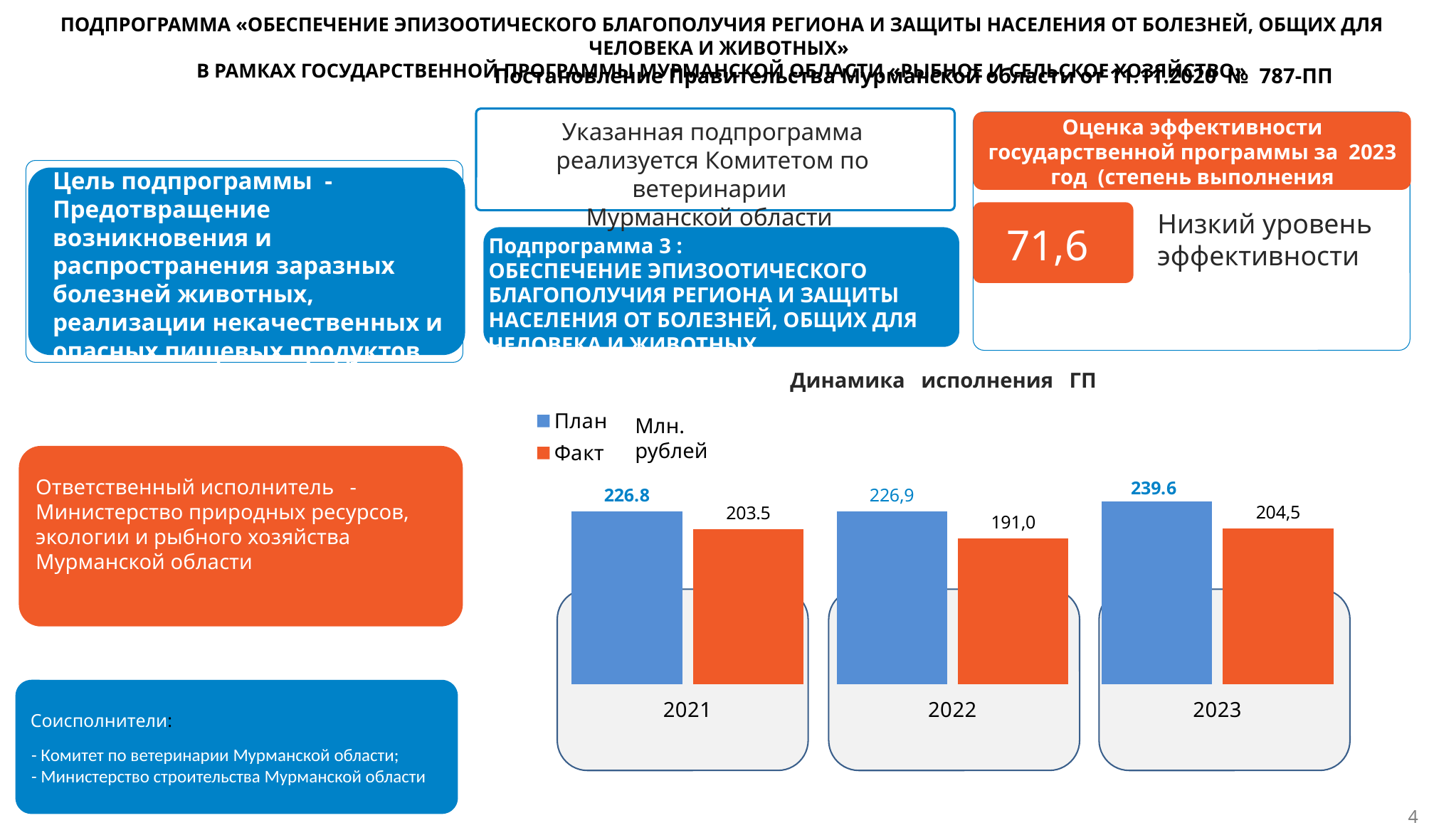
What is the Факт value for 2023 in the chart 'Динамика исполнения ГП'? 204,5 In the chart 'Динамика исполнения ГП', what unit is indicated next to the legend? Млн. рублей In the chart 'Динамика исполнения ГП', what is the difference between План and Факт for 2023? 35.1 In the chart 'Динамика исполнения ГП', what is the difference between План and Факт for 2021? 23.3 How many series does the legend of the chart 'Динамика исполнения ГП' list? 2 What kind of chart is 'Динамика исполнения ГП'? Bar chart What is the План value for 2021 in the chart 'Динамика исполнения ГП'? 226.8 What is the Факт value for 2022 in the chart 'Динамика исполнения ГП'? 191,0 How many years are shown on the x axis of the chart 'Динамика исполнения ГП'? 3 In the chart 'Динамика исполнения ГП', which year has the lowest Факт value? 2022 In the chart 'Динамика исполнения ГП', which year has the highest План value? 2023 In the chart 'Динамика исполнения ГП', which is larger for 2022: План or Факт? План